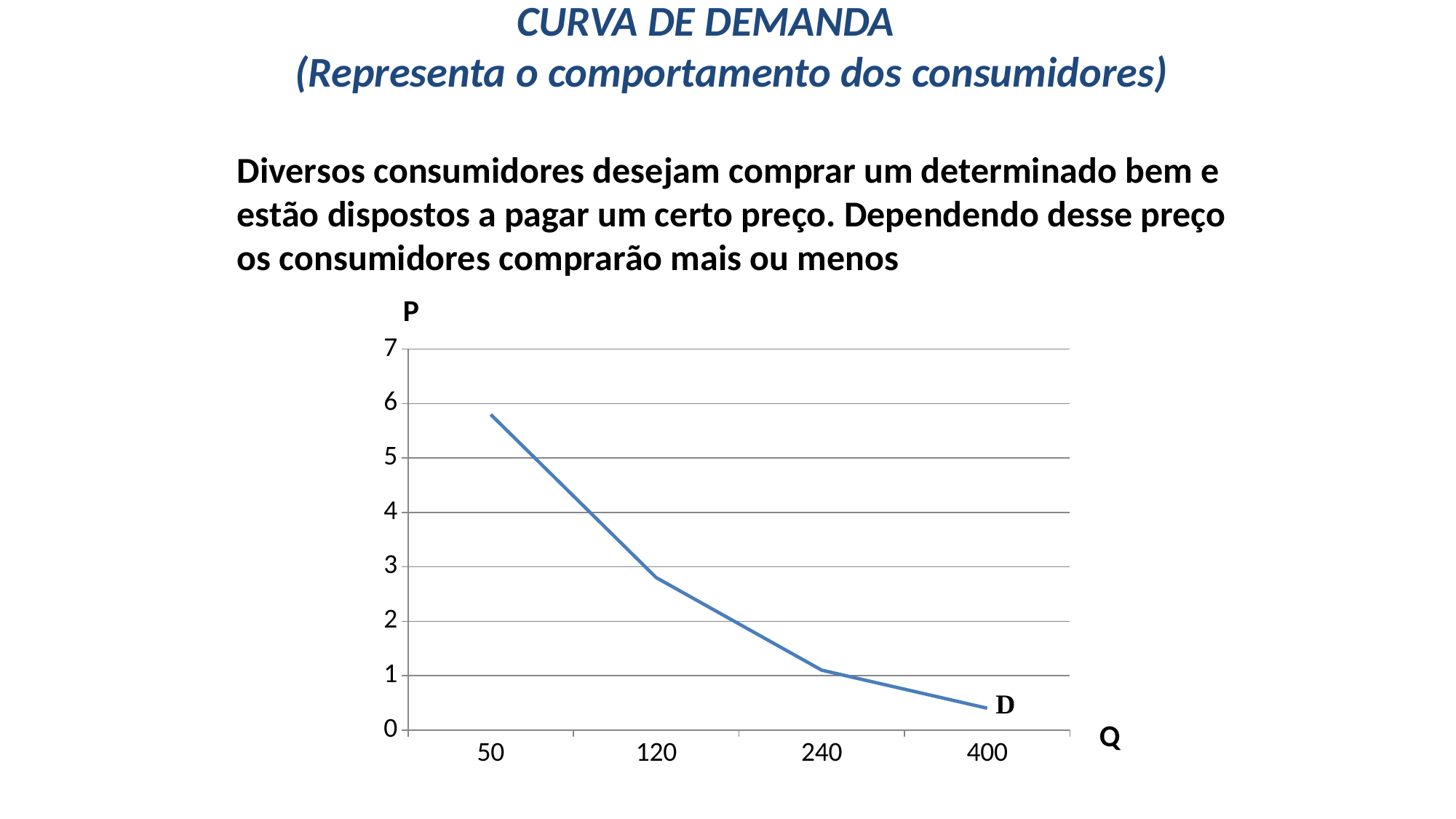
Is the value for Q = 240 greater or less than 2? less What letter labels the end of the plotted line? D What kind of chart is shown on the slide? line chart At which Q value is the plotted P value lowest? 400 Is the value for Q = 120 greater or less than 2? greater Do the values rise or fall as Q increases along the x axis? fall Which has a higher P value, Q = 50 or Q = 400? Q = 50 How many data points are plotted on the line? 4 Is the value for Q = 400 greater or less than 1? less What label is shown on the vertical axis of the chart? P At which Q value is the plotted P value highest? 50